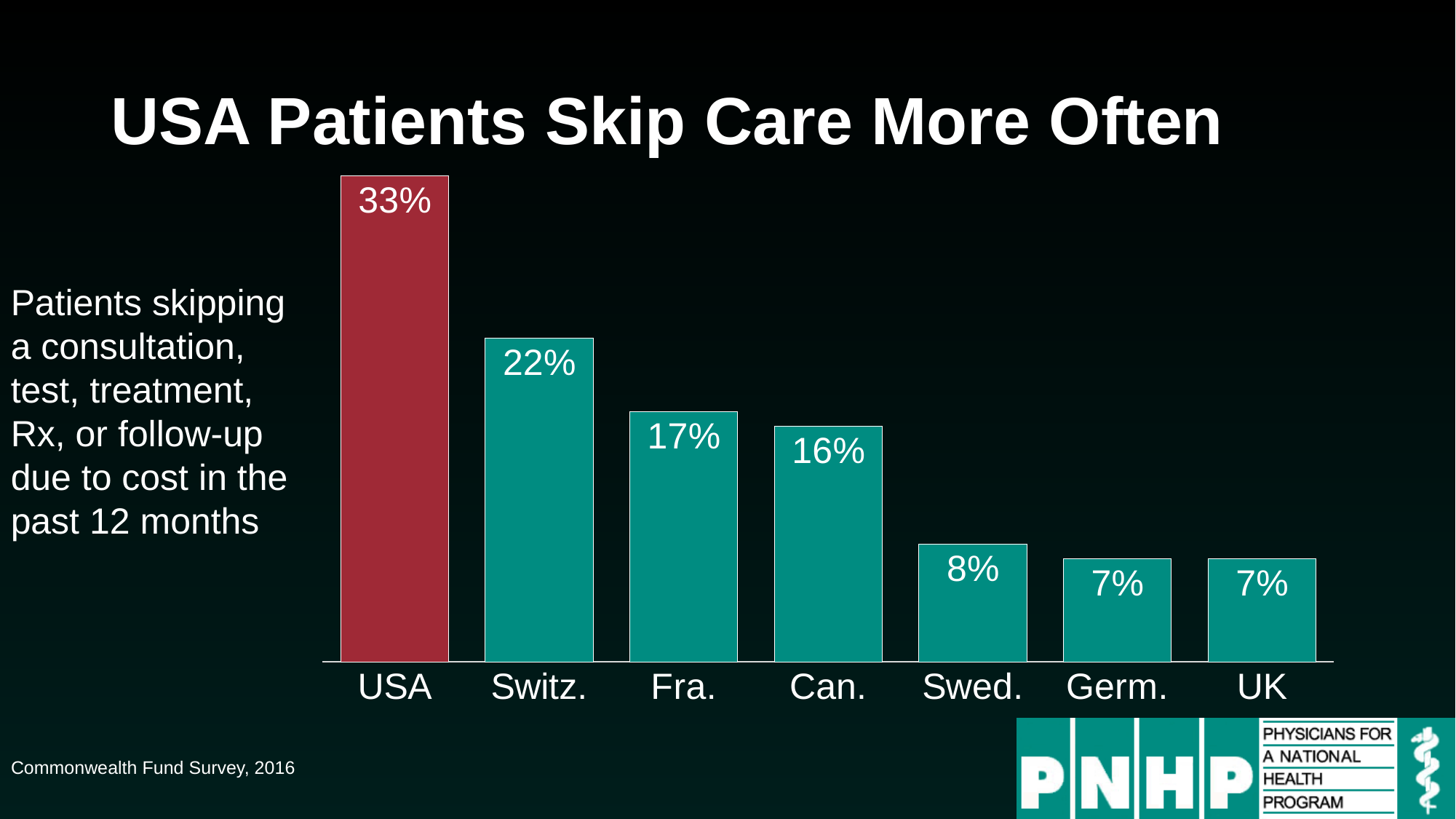
What is the value for Can.? 16% Which country has the highest value? USA What is the value for USA? 33% What kind of chart is shown on the slide? Bar chart What is the difference between the values for Fra. and Swed.? 9% Do the values rise or fall from left to right along the x axis? Fall How many countries are shown in the chart? 7 What is the value for Switz.? 22% What is the value for Swed.? 8% What is the difference between the values for USA and Switz.? 11% Which bar is coloured differently from the others? USA Which is larger, the value for Fra. or the value for Can.? Fra.